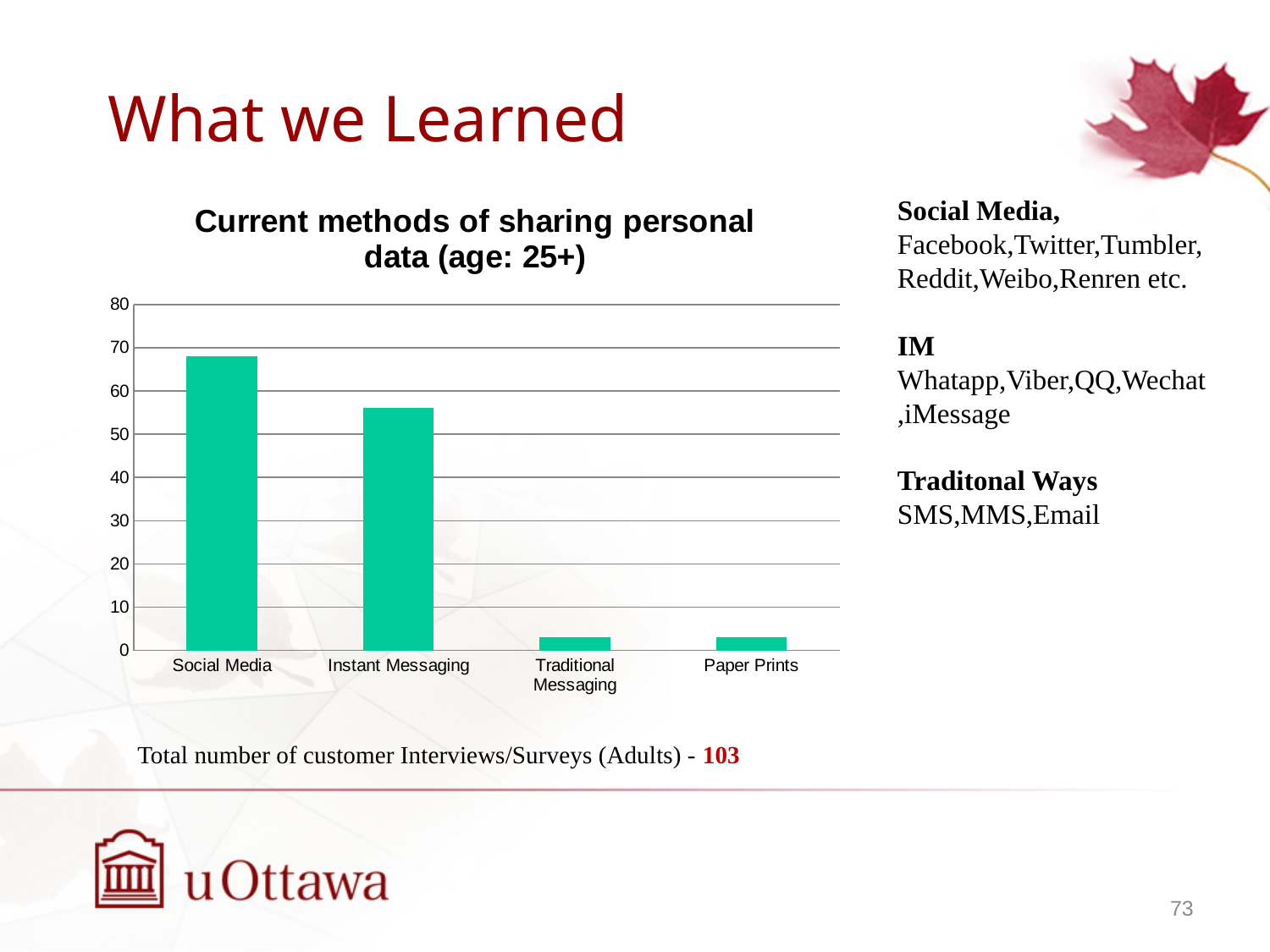
Do the bar values generally rise or fall from left to right across the x axis? fall What kind of chart is shown on the slide? bar chart How many categories are shown on the x axis of the chart? 4 Is the value for Traditional Messaging greater or less than 10? less What is the title of the chart? Current methods of sharing personal data (age: 25+) Which category has the highest value in the chart? Social Media Is the value for Paper Prints greater or less than 10? less Which is larger, the value for Instant Messaging or the value for Paper Prints? Instant Messaging Is the value for Instant Messaging greater or less than 50? greater Which is larger, the value for Social Media or the value for Instant Messaging? Social Media